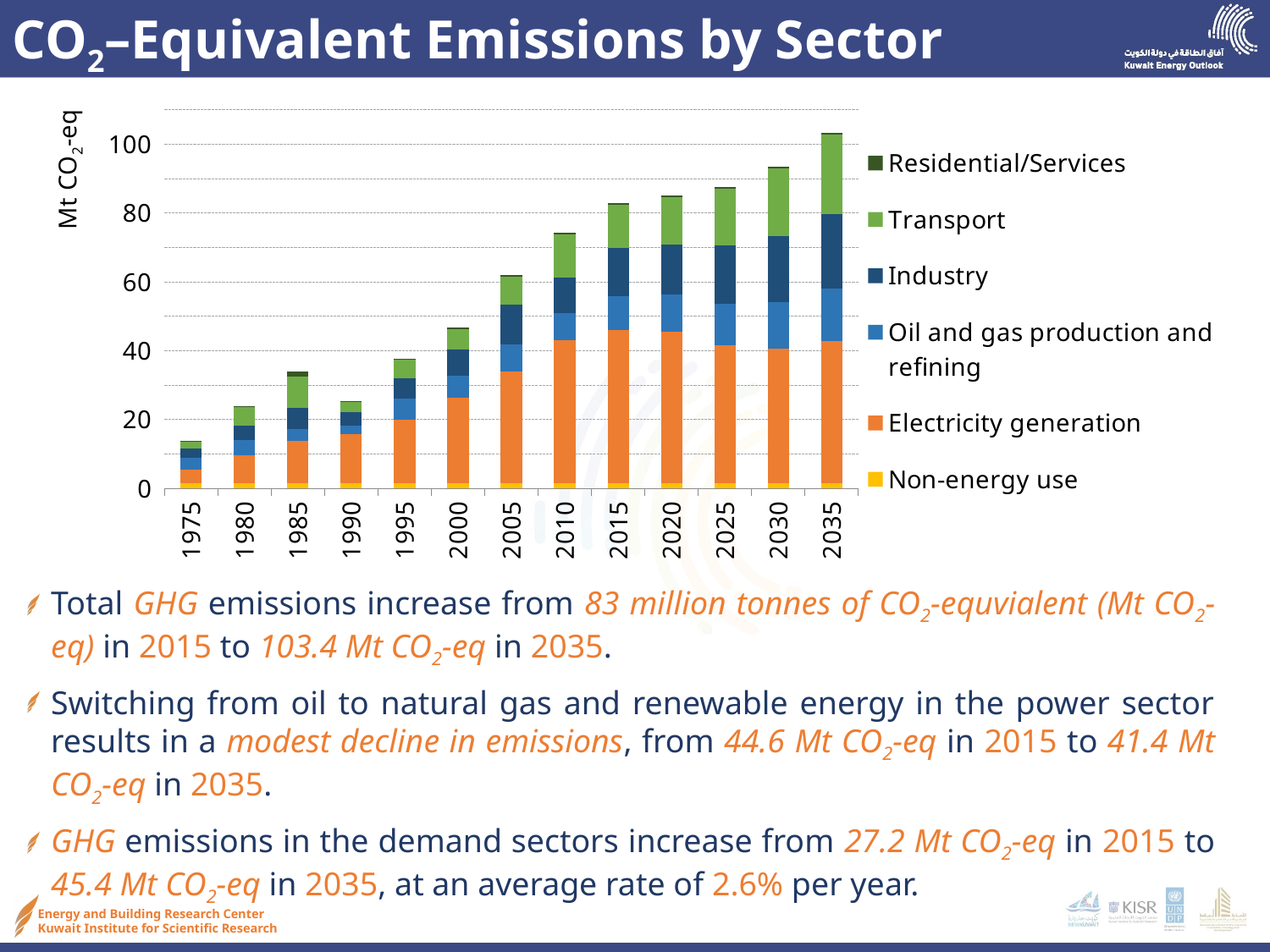
Is the total bar for 2035 greater or less than 100? greater Do total emissions generally rise or fall from 1975 to 2035? Rise How many years are shown along the x axis? 13 Which year has the highest total emissions? 2035 How many series does the legend list? 6 Which year has the larger total bar, 2000 or 2020? 2020 Is the total bar for 2000 greater or less than 40? greater Is the total bar for 1975 greater or less than 20? less What colour represents Electricity generation in the legend? Orange Which year has the lowest total emissions? 1975 What kind of chart is shown on the slide? Stacked bar chart